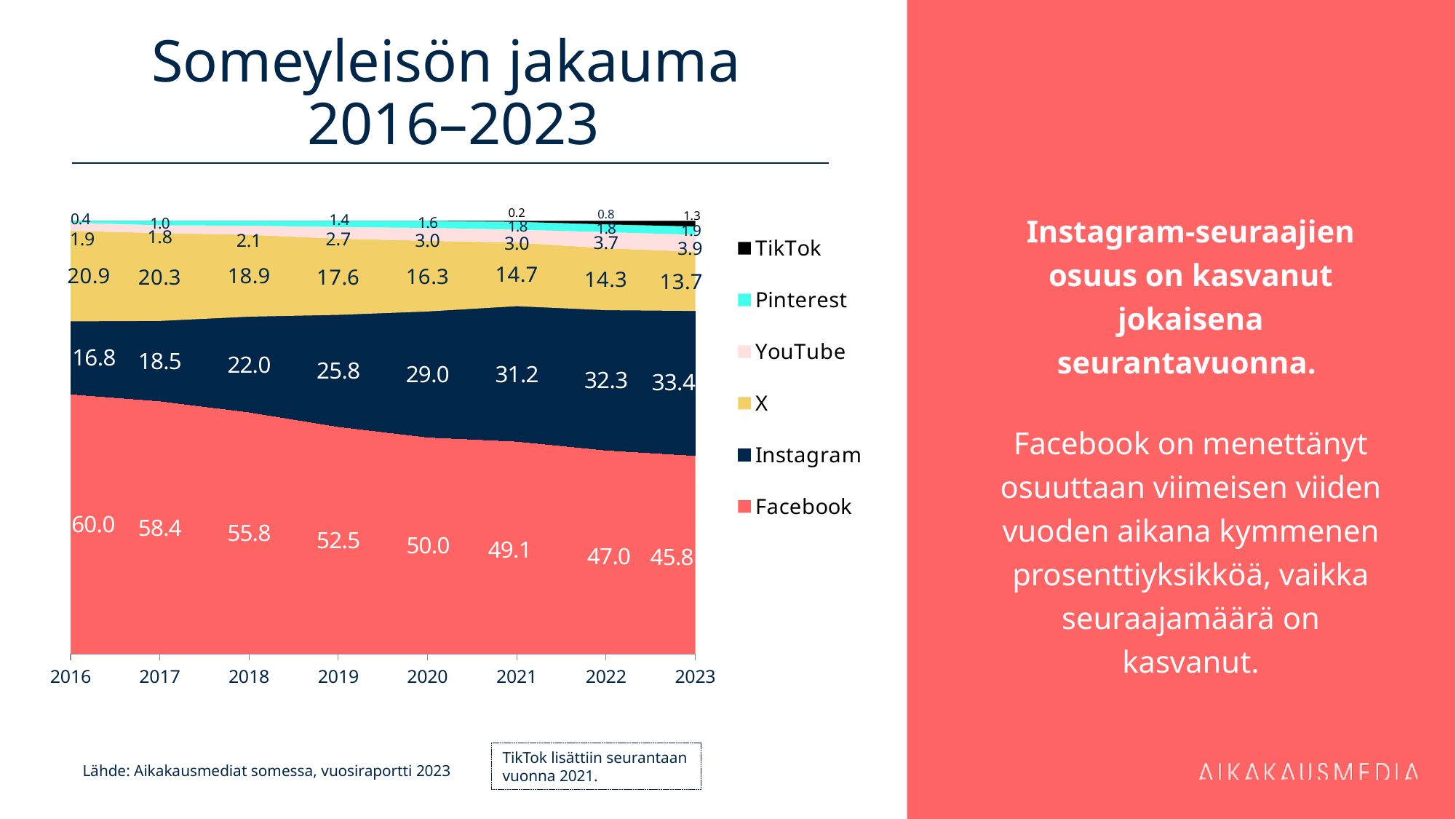
In 2018, which is larger: Instagram or X? Instagram What is the value for YouTube in 2023? 3.9 By how much did the Facebook value decrease from 2016 to 2023? 14.2 What is the value for TikTok in 2022? 0.8 In which year is the Facebook value lowest? 2023 Does the Facebook share rise or fall from 2016 to 2023? fall What is the value for X in 2019? 17.6 How many years are shown on the x axis? 8 Does the Instagram share rise or fall from 2016 to 2023? rise What is the value for Instagram in 2023? 33.4 What is the value for Facebook in 2016? 60.0 How many series does the legend list? 6